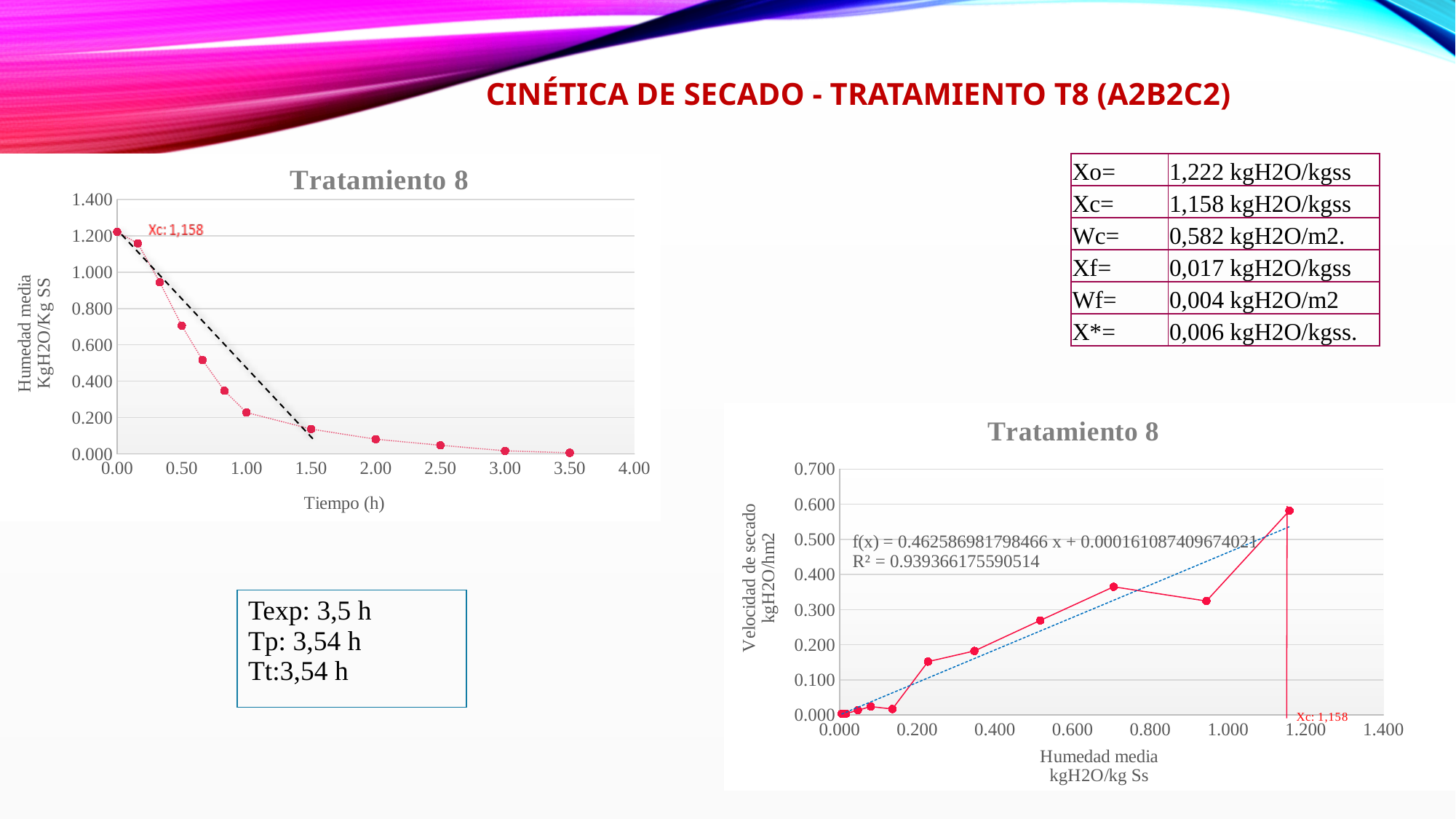
What Xc value is annotated on both charts? 1,158 In the right chart, what is the R² value printed for the trend line? 0.939366175590514 In the right chart, what is the slope of the printed trend line equation f(x)? 0.462586981798466 In the left chart, is the Humedad media value at 0.50 h greater or less than 0.600? greater In the right chart, is the highest Velocidad de secado value greater or less than 0.500? greater In the left chart (Humedad media vs Tiempo), do the values rise or fall as time increases? fall How many data points are plotted in the left chart (Humedad media vs Tiempo)? 12 What is the y-axis label of the right chart? Velocidad de secado kgH2O/hm2 What is the x-axis label of the left chart? Tiempo (h) In the left chart, is the Humedad media value at 1.00 h greater or less than 0.400? less What kind of chart is the left 'Tratamiento 8' chart (Humedad media vs Tiempo)? line chart In the right chart (Velocidad de secado vs Humedad media), do the values generally rise or fall as Humedad media increases? rise